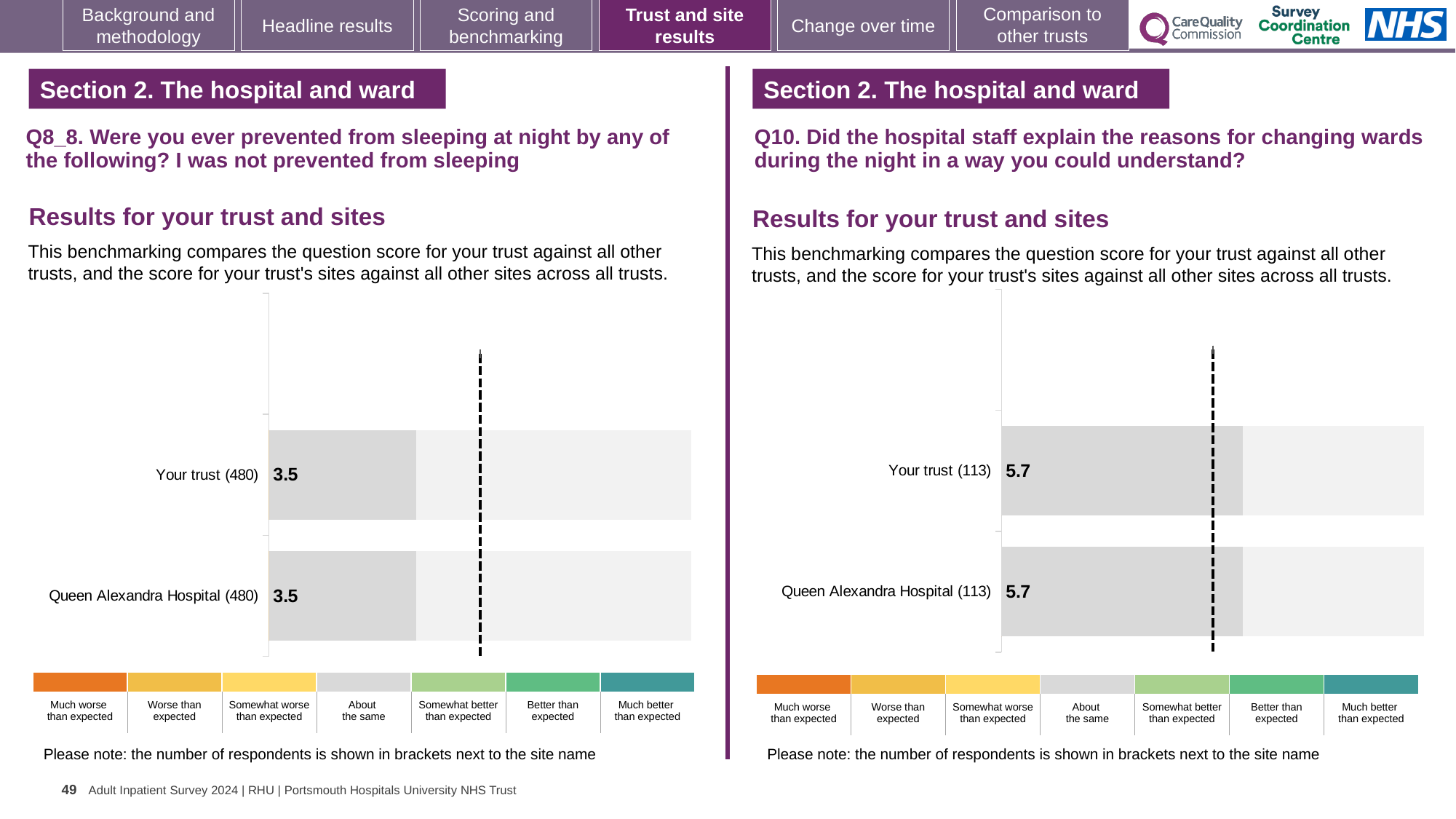
In the Q8_8 chart on the left, what is the score for Queen Alexandra Hospital? 3.5 In the Q8_8 chart on the left, how many respondents are shown in brackets next to Your trust? 480 How many bars are plotted in the Q10 chart on the right? 2 What kind of chart is used for the Q8_8 results on the left? Bar chart In the Q10 chart on the right, what is the difference between the score for Your trust and the score for Queen Alexandra Hospital? 0 How many bars are plotted in the Q8_8 chart on the left? 2 In the Q10 chart on the right, how many respondents are shown in brackets next to Queen Alexandra Hospital? 113 In the Q10 chart on the right, what is the score for Your trust? 5.7 In the Q8_8 chart on the left, what is the score for Your trust? 3.5 In the Q10 chart on the right, what is the score for Queen Alexandra Hospital? 5.7 In the Q8_8 chart on the left, what is the difference between the score for Your trust and the score for Queen Alexandra Hospital? 0